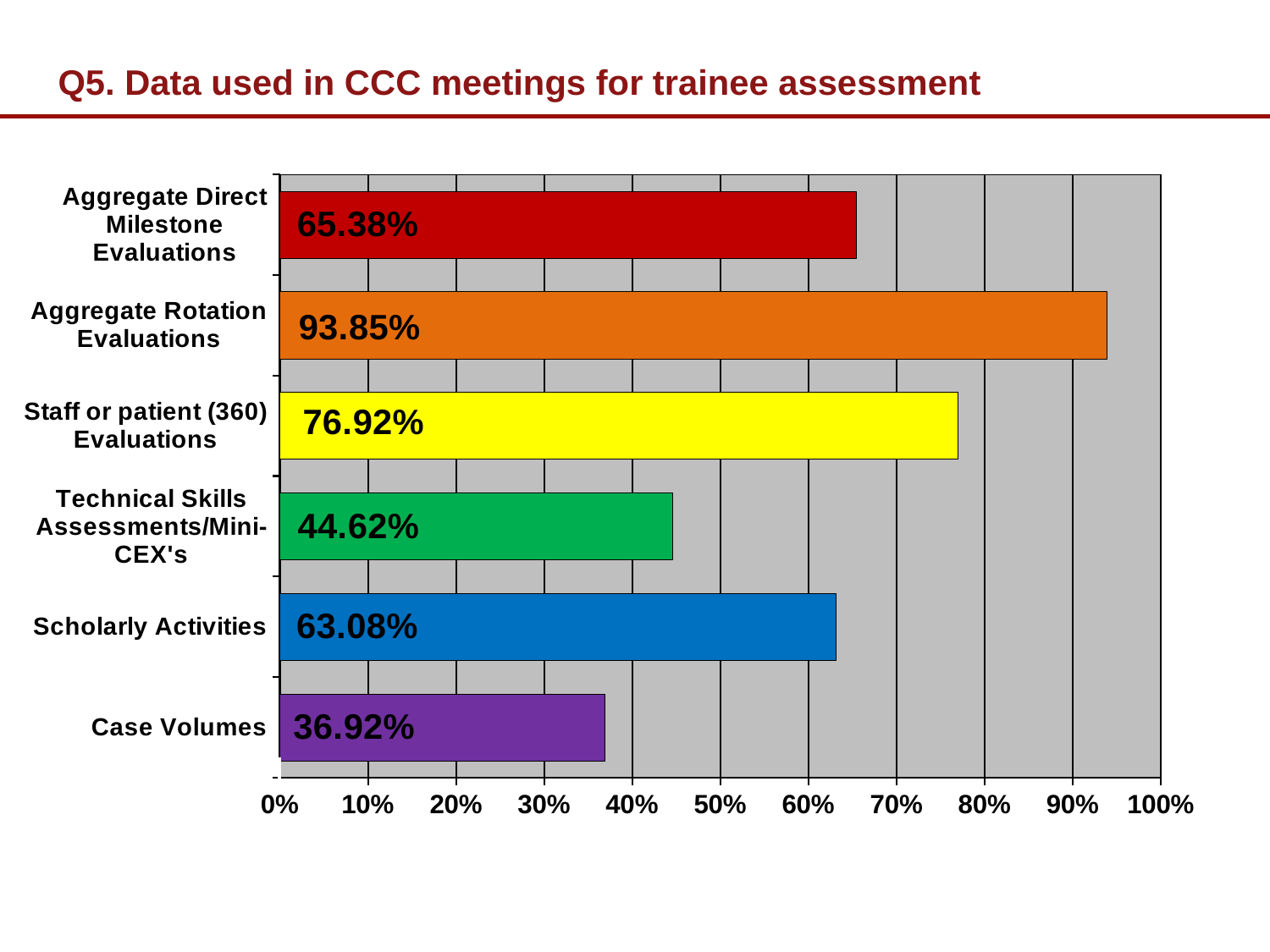
What is the value for Case Volumes? 36.92% Is the value for Staff or patient (360) Evaluations greater or less than 70%? greater Which is larger, Aggregate Direct Milestone Evaluations or Scholarly Activities? Aggregate Direct Milestone Evaluations What is the difference between Aggregate Rotation Evaluations and Staff or patient (360) Evaluations? 16.93% Which category has the highest value? Aggregate Rotation Evaluations What is the value for Aggregate Rotation Evaluations? 93.85% What is the value for Scholarly Activities? 63.08% What is the value for Technical Skills Assessments/Mini-CEX's? 44.62% What kind of chart is shown on the slide? bar chart How many categories are shown in the chart? 6 Which category has the lowest value? Case Volumes What is the title of the chart? Q5. Data used in CCC meetings for trainee assessment